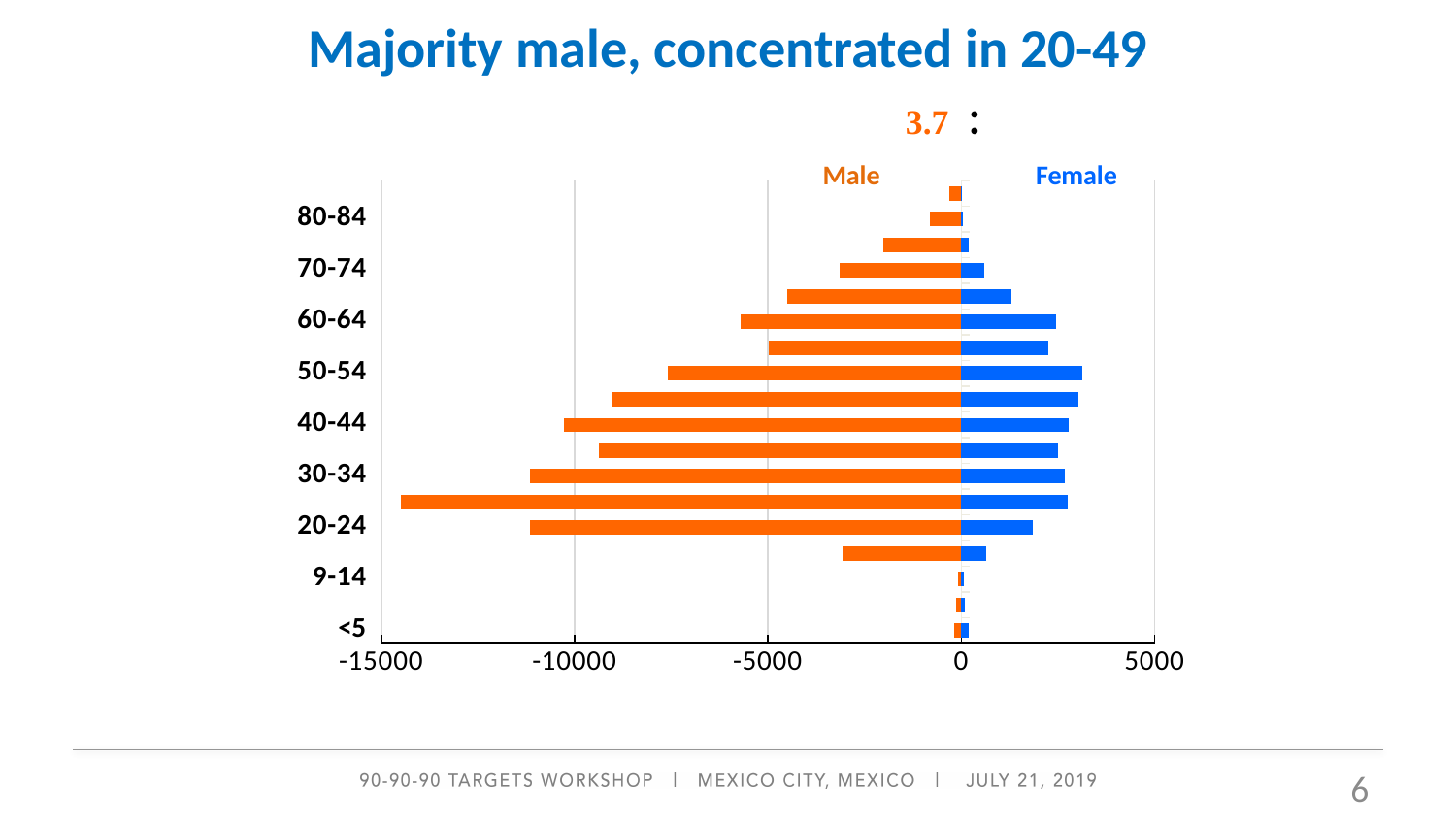
What kind of chart is shown on the slide? bar chart Which is longer, the Male bar for 40-44 or the Male bar for 50-54? Male bar for 40-44 Is the Female value for 50-54 greater or less than 5000? less Does the Male bar for 70-74 extend past the -5000 tick on the horizontal axis? no Moving down the labeled age groups from 80-84 to 20-24, do the Male bars get longer or shorter? longer Which colour represents the Male series in the chart? orange Does the Male bar for 30-34 extend past the -10000 tick on the horizontal axis? yes How many age-group labels are printed on the vertical axis of the chart? 9 For the 80-84 age group, which bar is longer, Male or Female? Male What is the title of the slide above the chart? Majority male, concentrated in 20-49 Which is longer, the Female bar for 50-54 or the Female bar for 20-24? Female bar for 50-54 How many series does the chart show (Male/Female)? 2